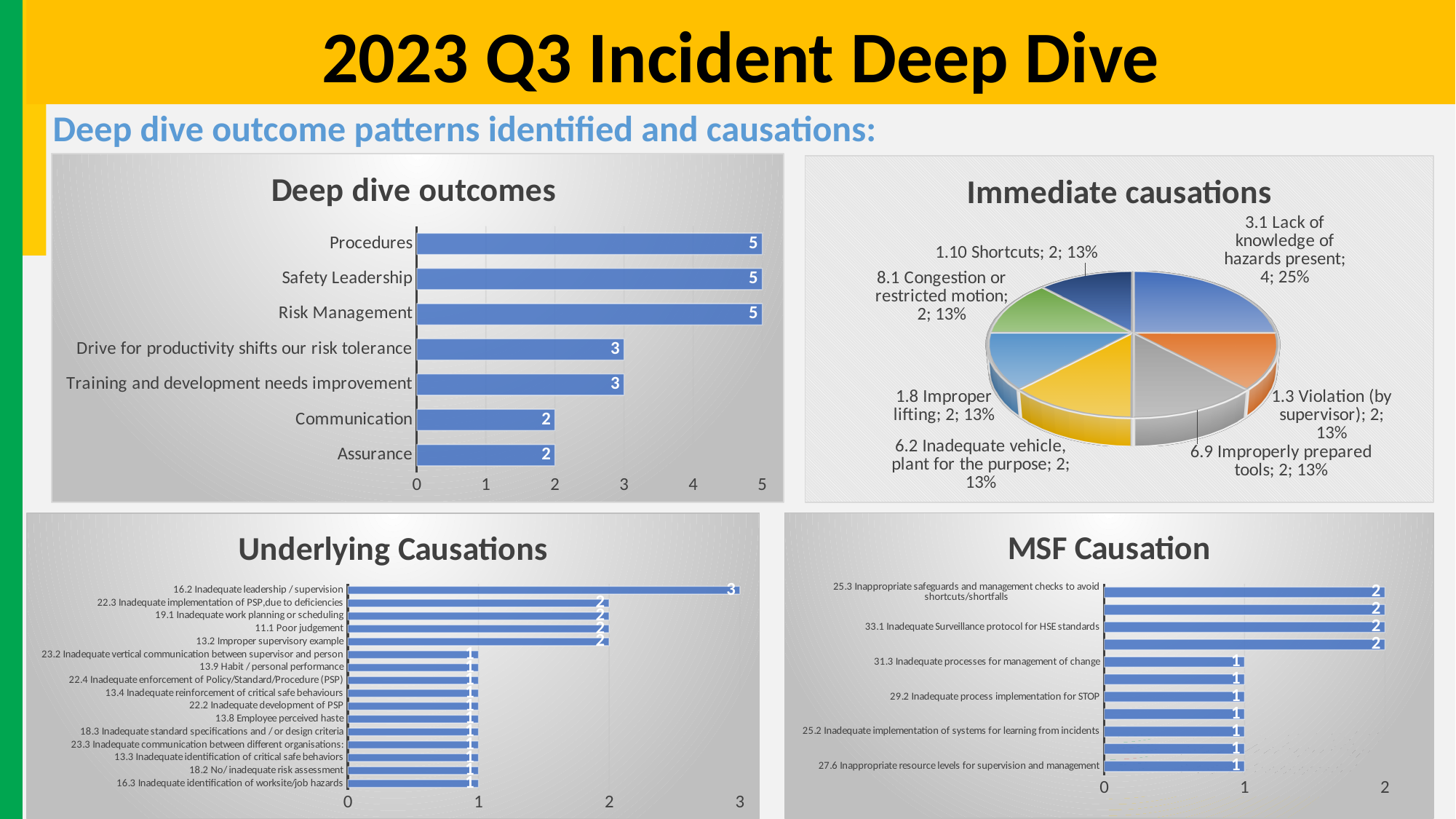
In the Deep dive outcomes chart, which is larger, Risk Management or Training and development needs improvement? Risk Management In the Underlying Causations chart, which category has the highest value? 16.2 Inadequate leadership / supervision In the Immediate causations chart, what is the value for 1.8 Improper lifting? 2 In the Underlying Causations chart, what is the value for 11.1 Poor judgement? 2 In the Immediate causations chart, what share of the pie is 3.1 Lack of knowledge of hazards present? 25% In the Deep dive outcomes chart, what is the value for Communication? 2 In the Deep dive outcomes chart, how many categories are plotted? 7 In the MSF Causation chart, what is the value for 31.3 Inadequate processes for management of change? 1 In the Deep dive outcomes chart, what is the value for Drive for productivity shifts our risk tolerance? 3 In the Deep dive outcomes chart, what is the difference between the values for Procedures and Assurance? 3 In the Immediate causations chart, which slice is the largest? 3.1 Lack of knowledge of hazards present What kind of chart is the Immediate causations chart? Pie chart